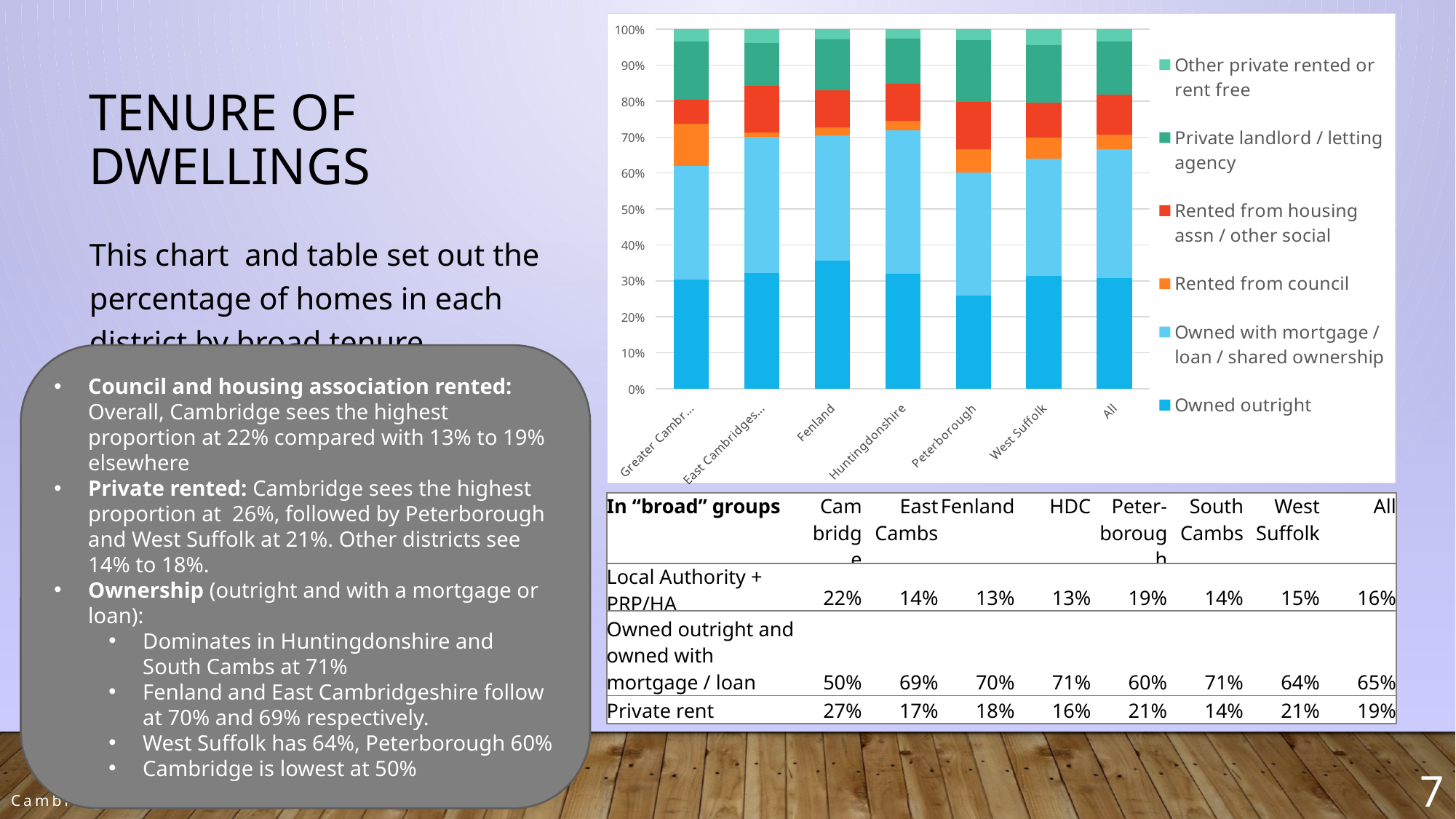
Which district has the largest 'Owned outright' segment in the chart? Fenland What kind of chart is shown on the slide? Stacked bar chart How many districts/categories are plotted along the x axis of the chart? 7 How many series does the chart's legend list? 6 Which district has the smallest 'Owned outright' segment in the chart? Peterborough What colour is used for the 'Rented from council' series in the chart? Orange Is the 'Owned outright' share for Peterborough greater or less than 30%? less What does each stacked bar in the chart total? 100% Is the 'Owned outright' share for Fenland greater or less than 30%? greater Which has the larger 'Rented from housing assn / other social' segment, Peterborough or Huntingdonshire? Peterborough Which series forms the bottom segment of each stacked bar? Owned outright Which has the larger 'Owned outright' segment, Fenland or Peterborough? Fenland